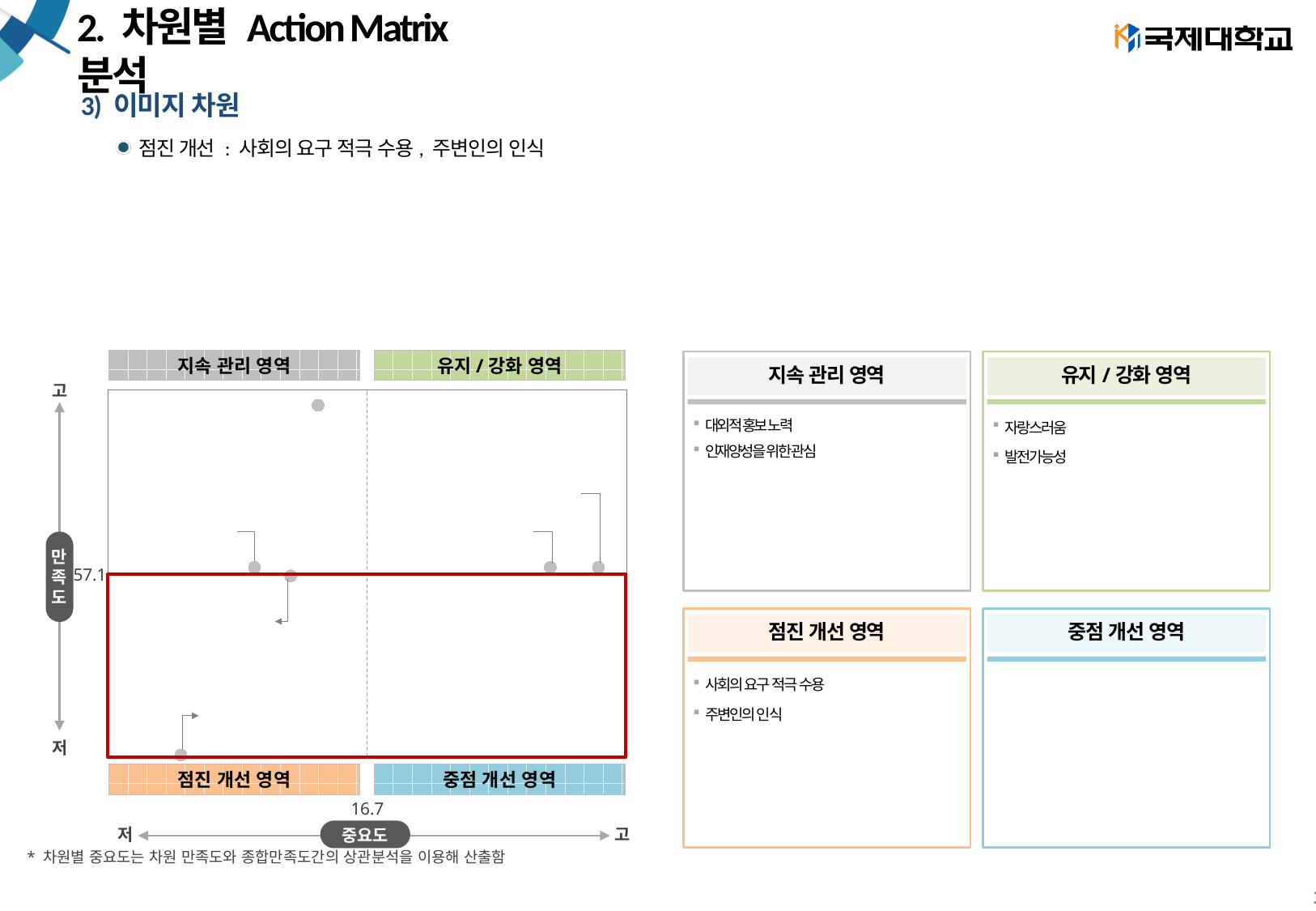
Which quadrant of the action matrix chart is outlined with a red box? 점진 개선 영역 and 중점 개선 영역 (the whole bottom half) Is the lowest data point in the action matrix chart above or below the 57.1 satisfaction line? below What kind of chart is shown on the left of the slide? scatter chart What is the label of the vertical axis of the action matrix chart? 만족도 What importance (중요도) value is marked by the vertical reference line in the action matrix chart? 16.7 What satisfaction (만족도) value is marked by the horizontal reference line in the action matrix chart? 57.1 How many data points fall in the 중점 개선 영역 (bottom-right) quadrant of the action matrix chart? 0 How many data points are plotted in the action matrix chart? 6